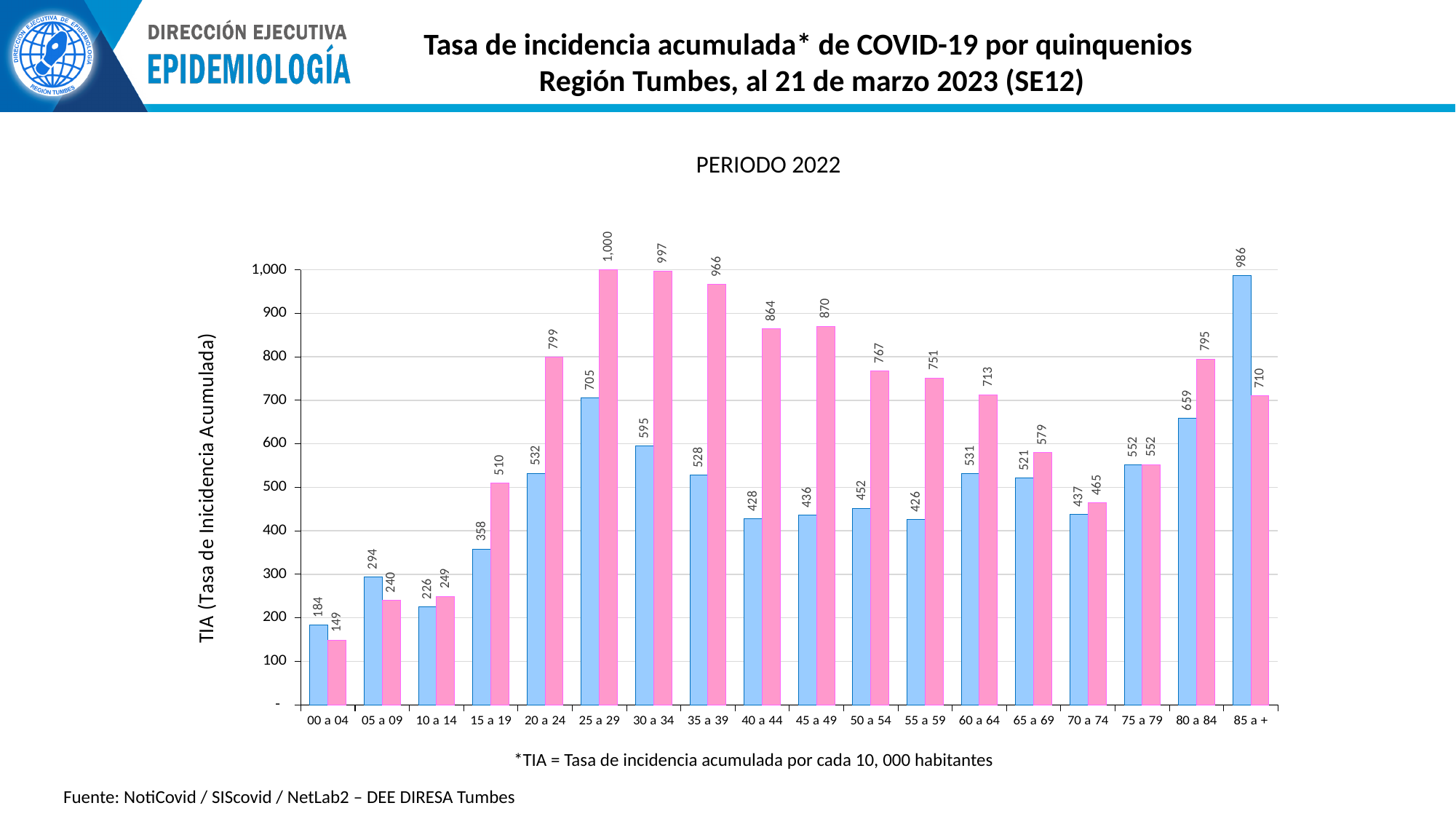
How many age groups are shown on the x axis? 18 Which is larger for the 00 a 04 age group, the blue bar or the pink bar? the blue bar What kind of chart is shown on the slide? bar chart What is the value of the blue bar for the 25 a 29 age group? 705 Which age group has the lowest blue bar? 00 a 04 What is the value of the blue bar for the 85 a + age group? 986 Is the value of the pink bar for the 20 a 24 age group greater or less than 700? greater Which age group has the highest pink bar? 25 a 29 What is the value of the pink bar for the 45 a 49 age group? 870 What is the title shown above the chart? PERIODO 2022 What is the y-axis label of the chart? TIA (Tasa de Incidencia Acumulada) What is the difference between the pink and blue bars for the 35 a 39 age group? 438